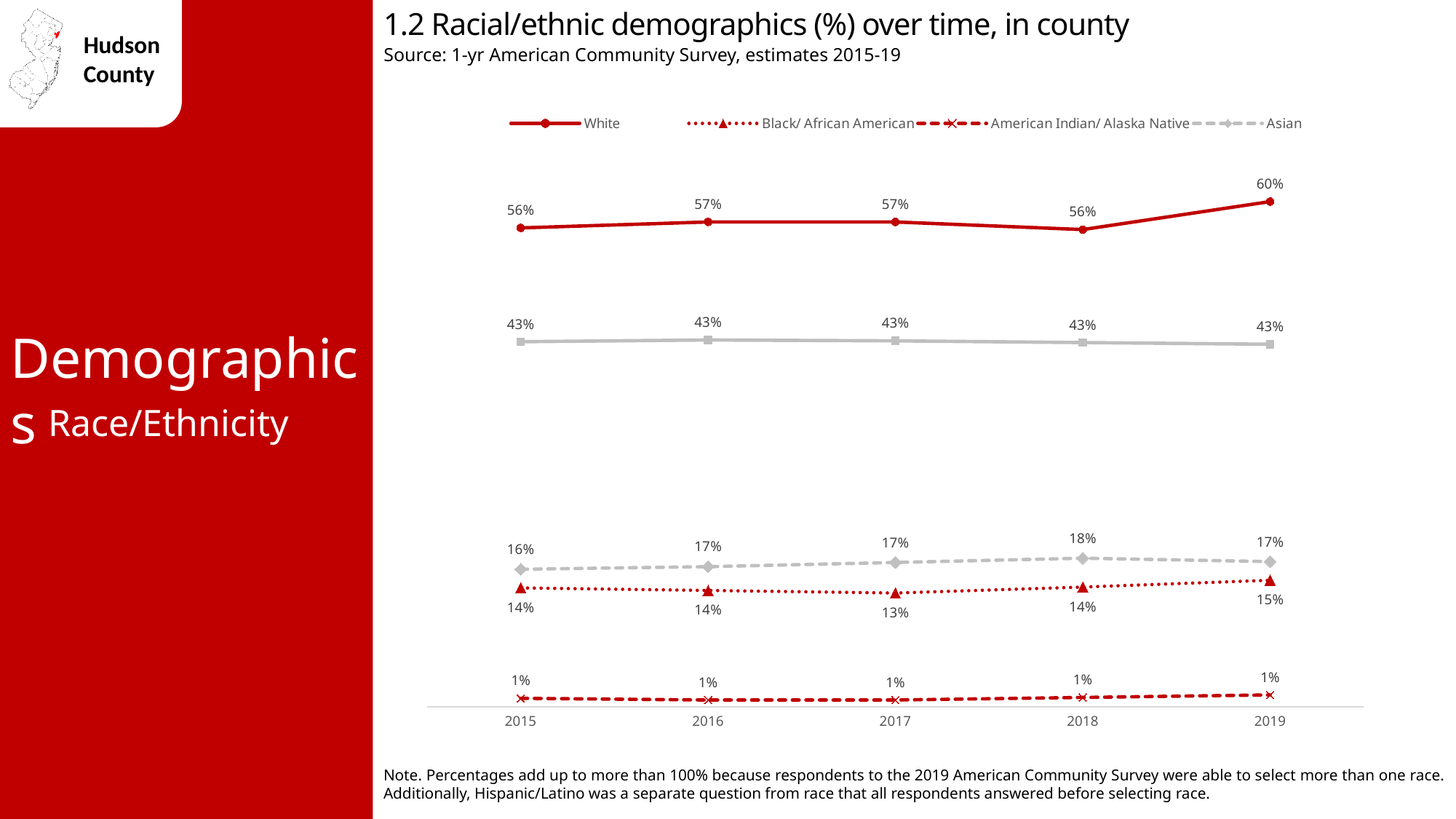
What is the source cited under the chart title? 1-yr American Community Survey, estimates 2015-19 In which year is the value for Black/ African American lowest? 2017 In which year is the value for White highest? 2019 How many years are shown on the x axis of the chart? 5 Which is larger in 2019, the value for Asian or the value for Black/ African American? Asian What is the value for American Indian/ Alaska Native in 2016? 1% What is the value for Asian in 2018? 18% How many series does the chart legend list? 4 What type of chart is shown on the slide? line chart What is the value for White in 2019? 60% What is the difference between the White value in 2019 and the White value in 2018? 4% What is the value for Black/ African American in 2017? 13%